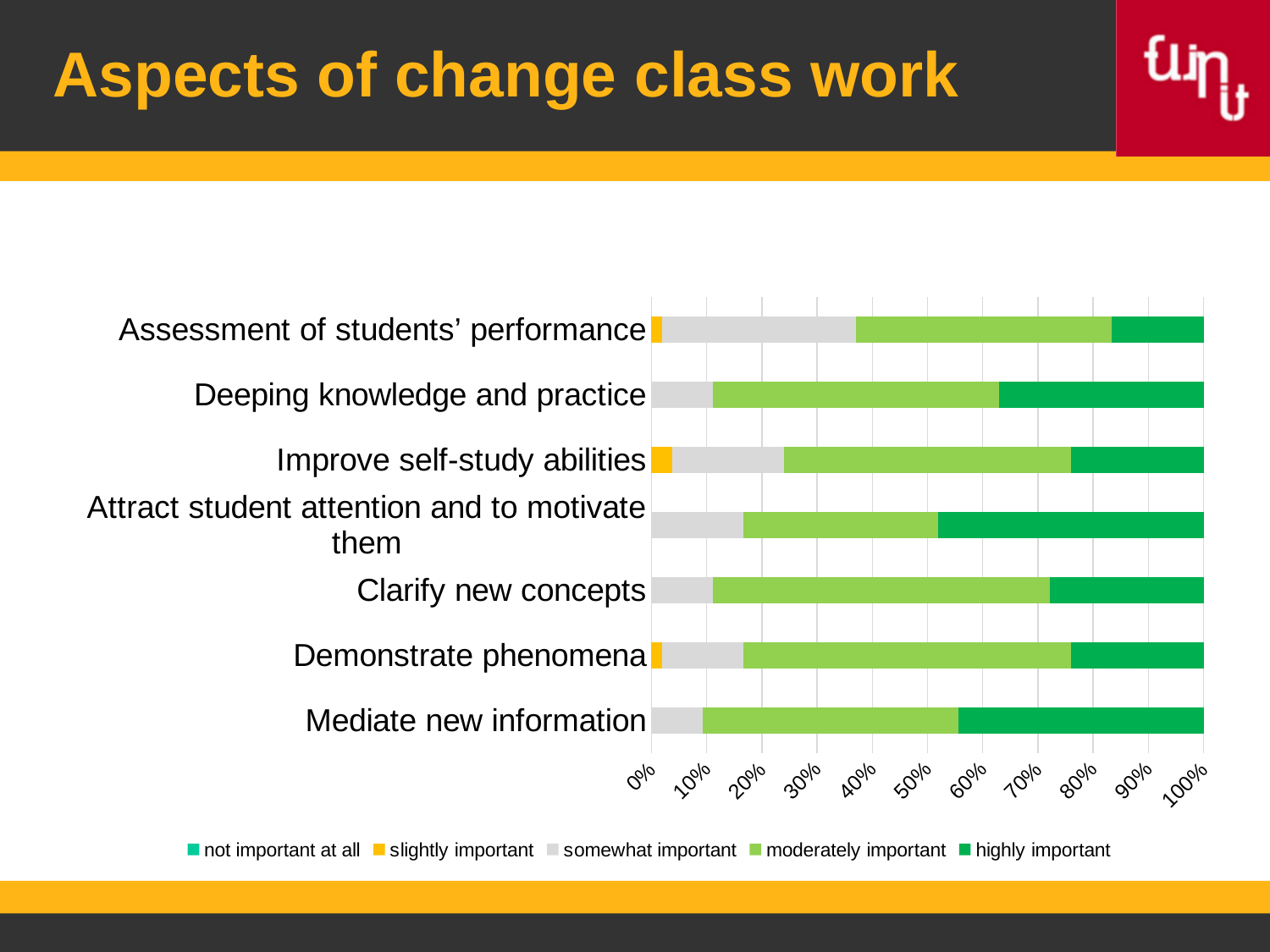
What kind of chart is shown on the slide? stacked bar chart Which category has the largest 'somewhat important' share? Assessment of students' performance Which category has the smallest 'highly important' share? Assessment of students' performance Which legend entry is shown in yellow? slightly important How many series does the legend list? 5 Is the 'highly important' share for 'Attract student attention and to motivate them' greater or less than 40%? greater Is the 'highly important' share for 'Assessment of students' performance' greater or less than 20%? less Is the 'somewhat important' share for 'Assessment of students' performance' greater or less than 30%? greater Which has the larger 'highly important' share: 'Deeping knowledge and practice' or 'Assessment of students' performance'? Deeping knowledge and practice What is the title of the slide containing the chart? Aspects of change class work How many categories (aspects) are listed on the chart? 7